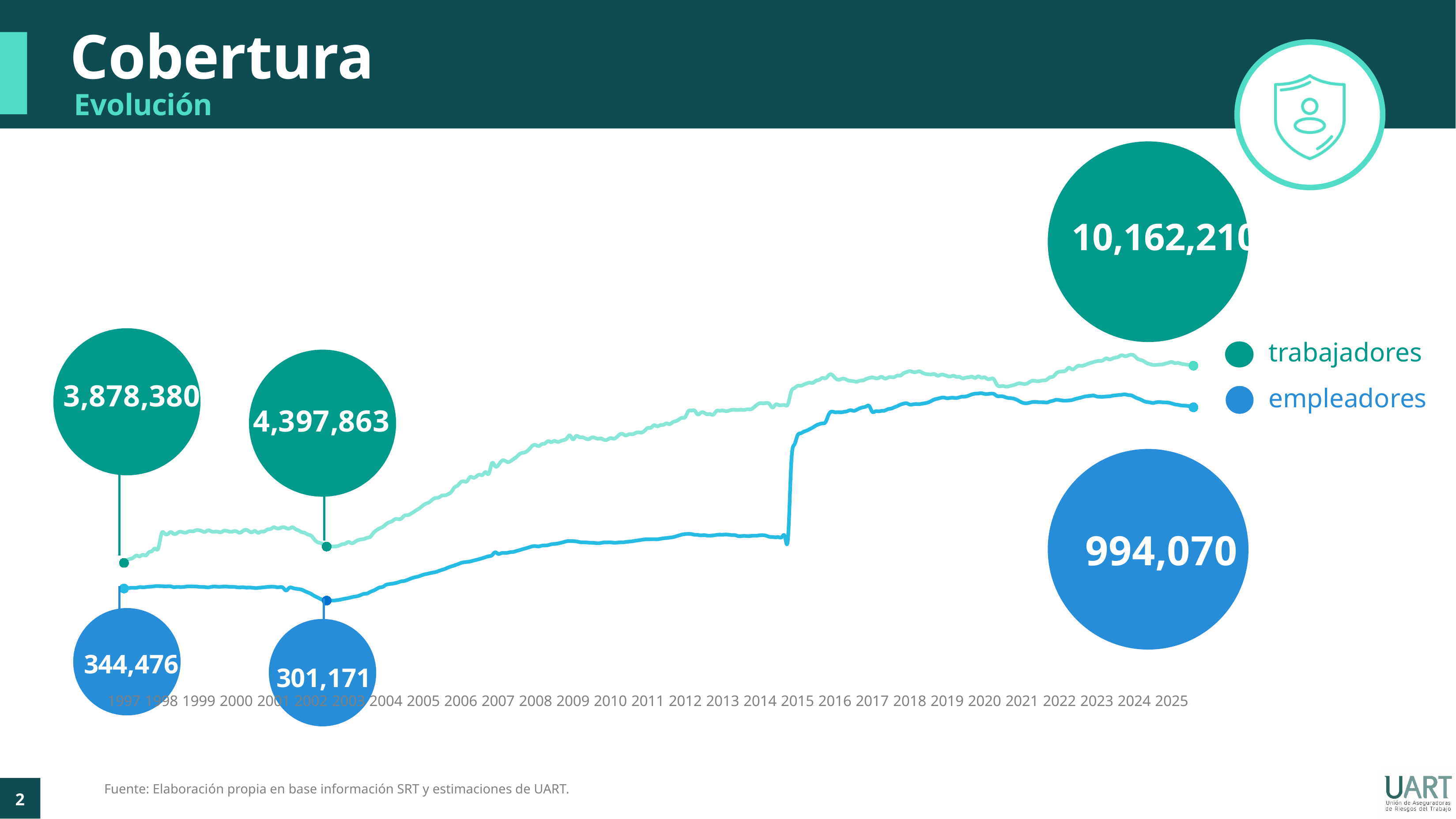
What is the labelled value for empleadores at the end of the series (2025)? 994,070 What is the difference between the labelled empleadores values for 1997 and 2002? 43,305 What is the labelled value for trabajadores in 2002? 4,397,863 What kind of chart is shown on the slide? line chart What is the labelled value for trabajadores in 1997? 3,878,380 How many series does the legend list? 2 By how much did the labelled trabajadores value increase from 1997 to 2002? 519,483 What are the two series named in the legend? trabajadores and empleadores Which is larger, the empleadores value in 1997 or in 2002? 1997 What is the labelled value for empleadores in 2002? 301,171 Overall, does the trabajadores line rise or fall from 1997 to 2025? rise What is the labelled value for empleadores in 1997? 344,476